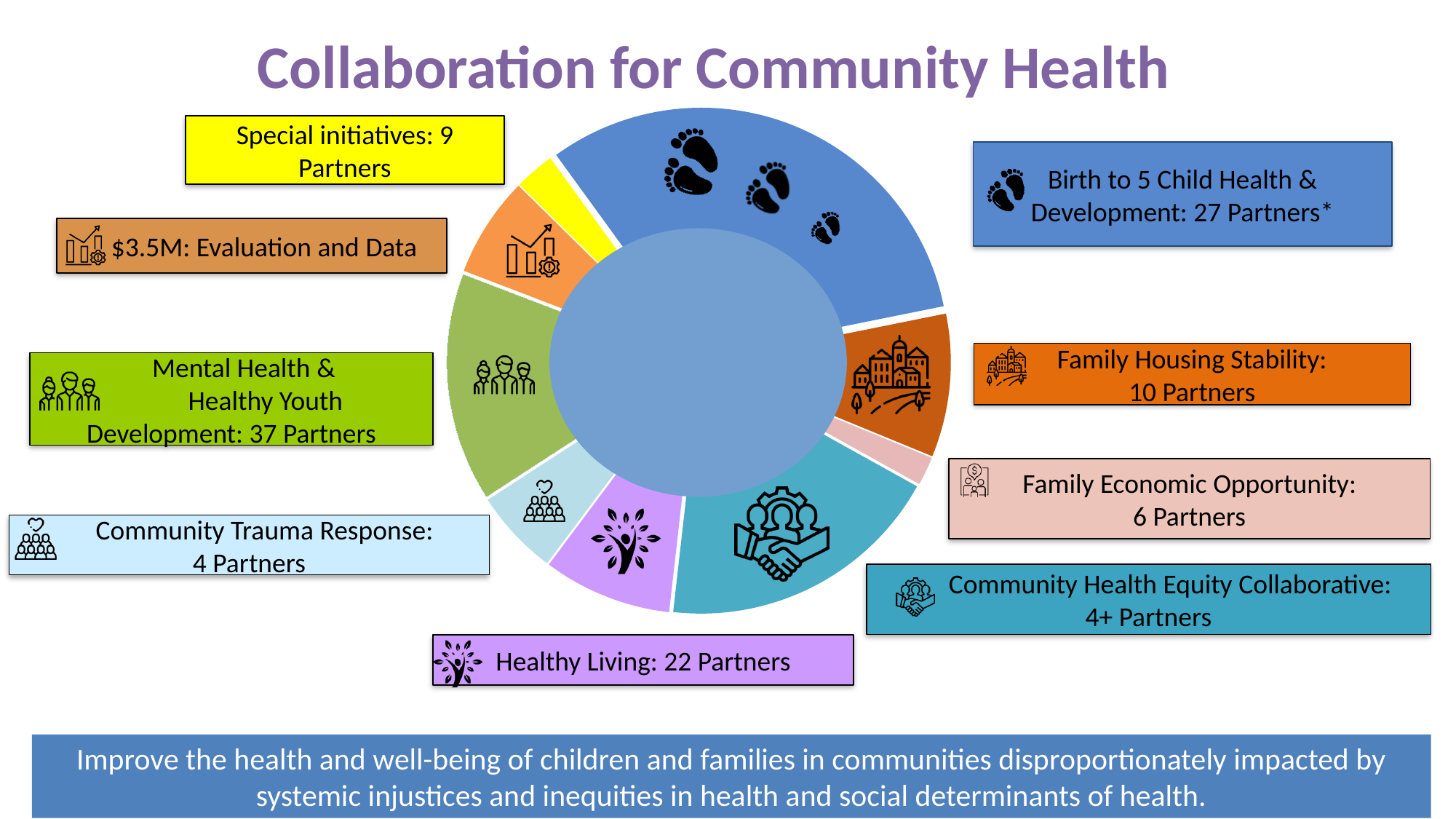
What is the title of the slide? Collaboration for Community Health Which initiative has the most partners according to the labels? Mental Health & Healthy Youth Development How many partners does Community Trauma Response have? 4 Partners What is the difference in partner count between Mental Health & Healthy Youth Development and Healthy Living? 15 How many partners does Birth to 5 Child Health & Development have? 27 Partners What amount is shown for Evaluation and Data? $3.5M Which has more partners, Healthy Living or Birth to 5 Child Health & Development? Birth to 5 Child Health & Development How many partners does Mental Health & Healthy Youth Development have? 37 Partners What kind of chart is shown on the slide? donut (pie) chart How many partners does Family Housing Stability have? 10 Partners How many segments does the donut chart have? 9 How many partners does Healthy Living have? 22 Partners